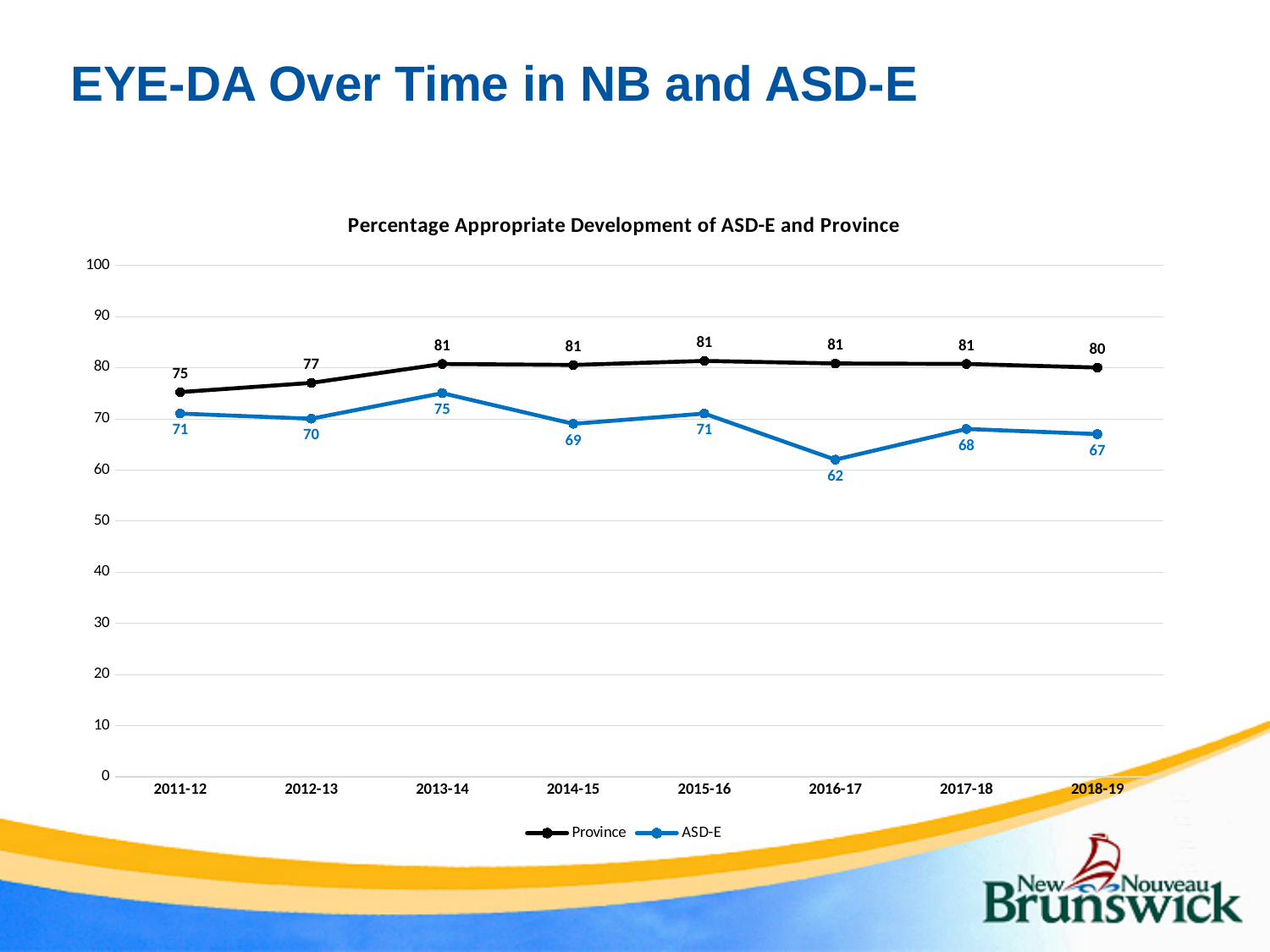
Which is larger in 2014-15, the Province value or the ASD-E value? Province How many series does the legend list? 2 What is the difference between the Province and ASD-E values in 2011-12? 4 How many years are shown on the x axis? 8 What is the ASD-E value for 2018-19? 67 In which year is the ASD-E value lowest? 2016-17 In which year is the ASD-E value highest? 2013-14 What is the ASD-E value for 2016-17? 62 What is the difference between the Province and ASD-E values in 2016-17? 19 What is the Province value for 2011-12? 75 What is the title of the chart? Percentage Appropriate Development of ASD-E and Province What kind of chart is this? Line chart